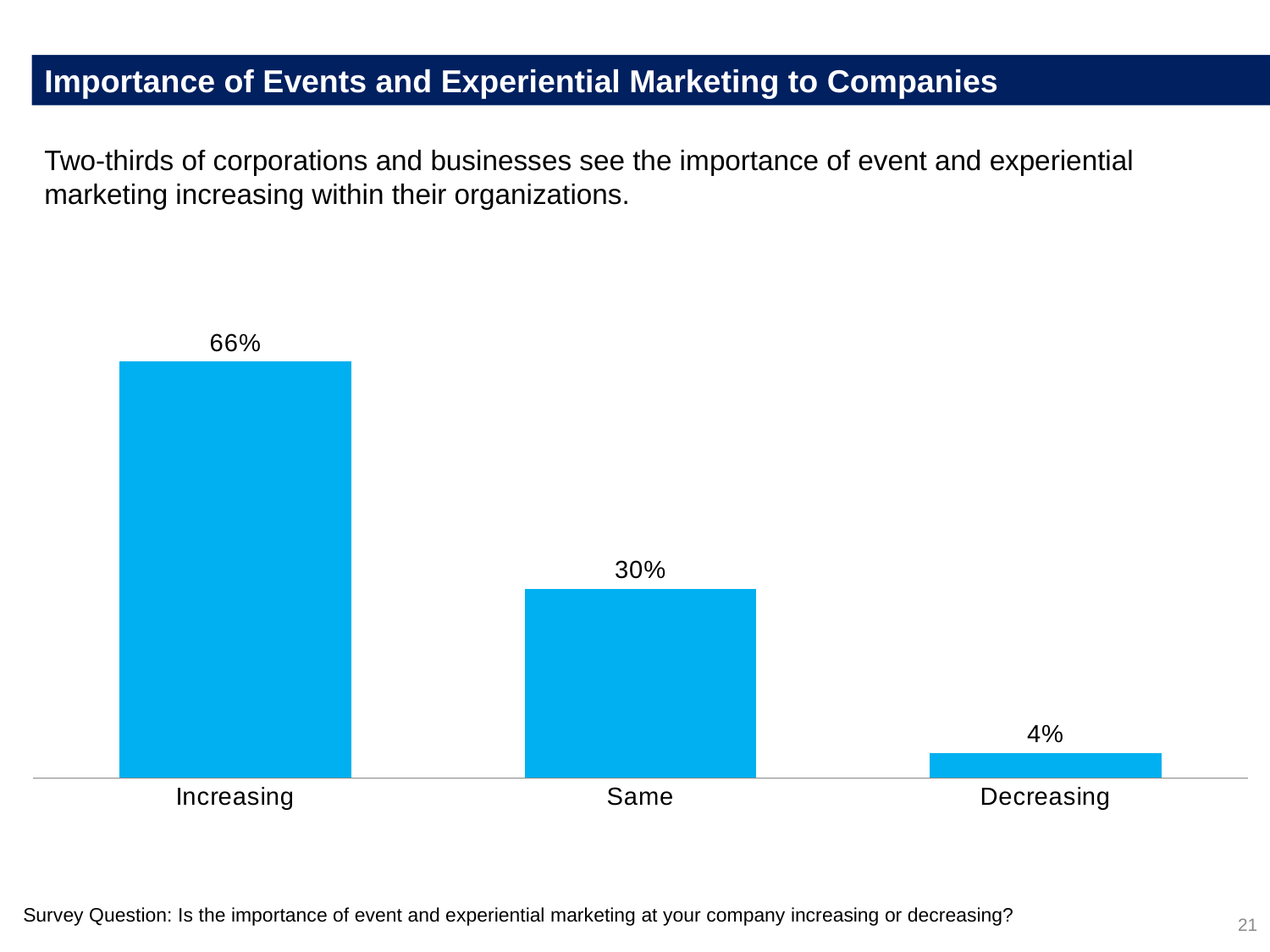
Which is larger, the value for Same or the value for Decreasing? Same What kind of chart is shown on the slide? Bar chart What is the difference between the values for Increasing and Same? 36% What is the value for Increasing? 66% How many categories are shown on the chart? 3 What is the title of the slide containing the chart? Importance of Events and Experiential Marketing to Companies Which category has the lowest value? Decreasing What is the value for Same? 30% Do the values rise or fall from left to right across the categories? Fall What is the value for Decreasing? 4% What is the difference between the values for Same and Decreasing? 26% Which category has the highest value? Increasing